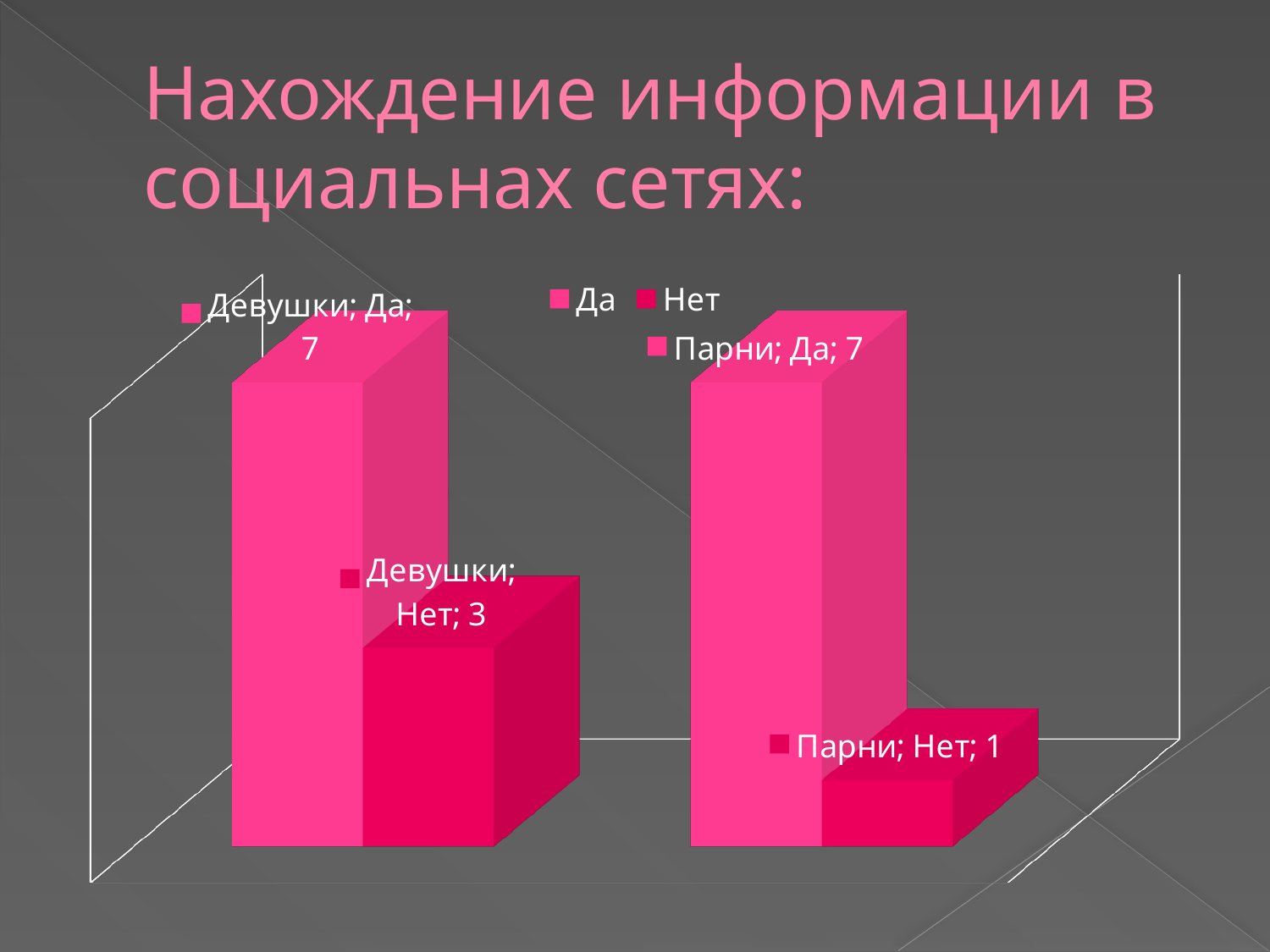
What is the value for Парни in the Нет series? 1 What is the value for Девушки in the Нет series? 3 What kind of chart is shown on the slide? Bar chart Which category has the highest value in the Нет series? Девушки What is the value for Парни in the Да series? 7 What is the title of the slide? Нахождение информации в социальнах сетях: Which category has the lowest value in the Нет series? Парни Which is larger: the Нет value for Девушки or the Нет value for Парни? Девушки What is the difference between the Нет values for Девушки and Парни? 2 What is the value for Девушки in the Да series? 7 How many series does the legend list? 2 What is the difference between the Да and Нет values for Девушки? 4